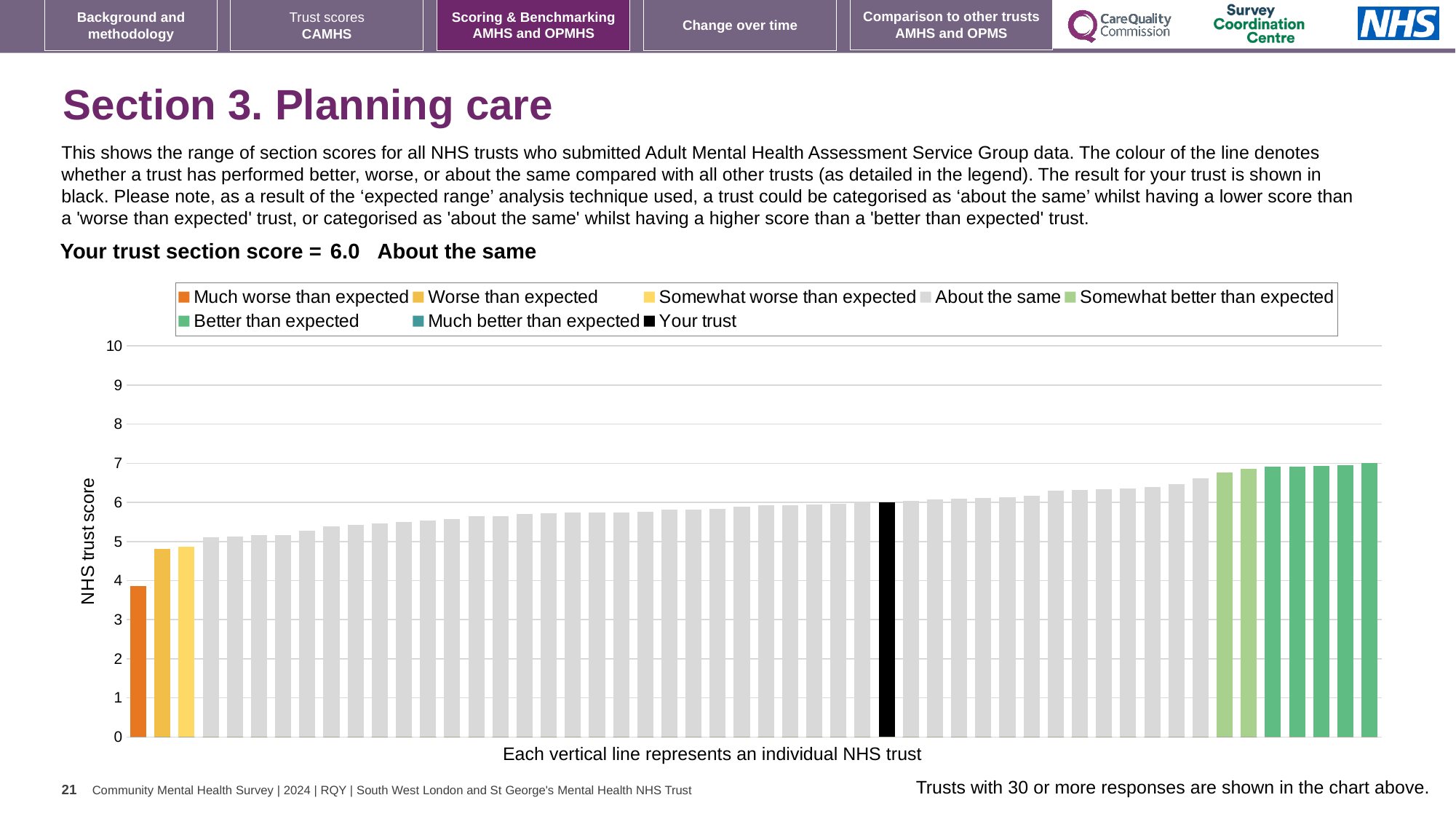
Is the value of the leftmost (orange) bar greater or less than 5? less How many entries does the chart legend list? 8 What kind of chart is shown on the slide? bar chart Is the value of the rightmost bar greater or less than 6? greater What is the highest value shown on the vertical axis? 10 What colour is the bar representing your trust? black How many bars are coloured orange (Much worse than expected)? 1 Which is larger, the value of the black 'Your trust' bar or the value of the leftmost orange bar? Your trust What is the section score for your trust shown on the slide? 6.0 Is the value for Your trust greater or less than 5? greater What is the label on the vertical axis of the chart? NHS trust score Do the bar values rise or fall from left to right along the x axis? rise